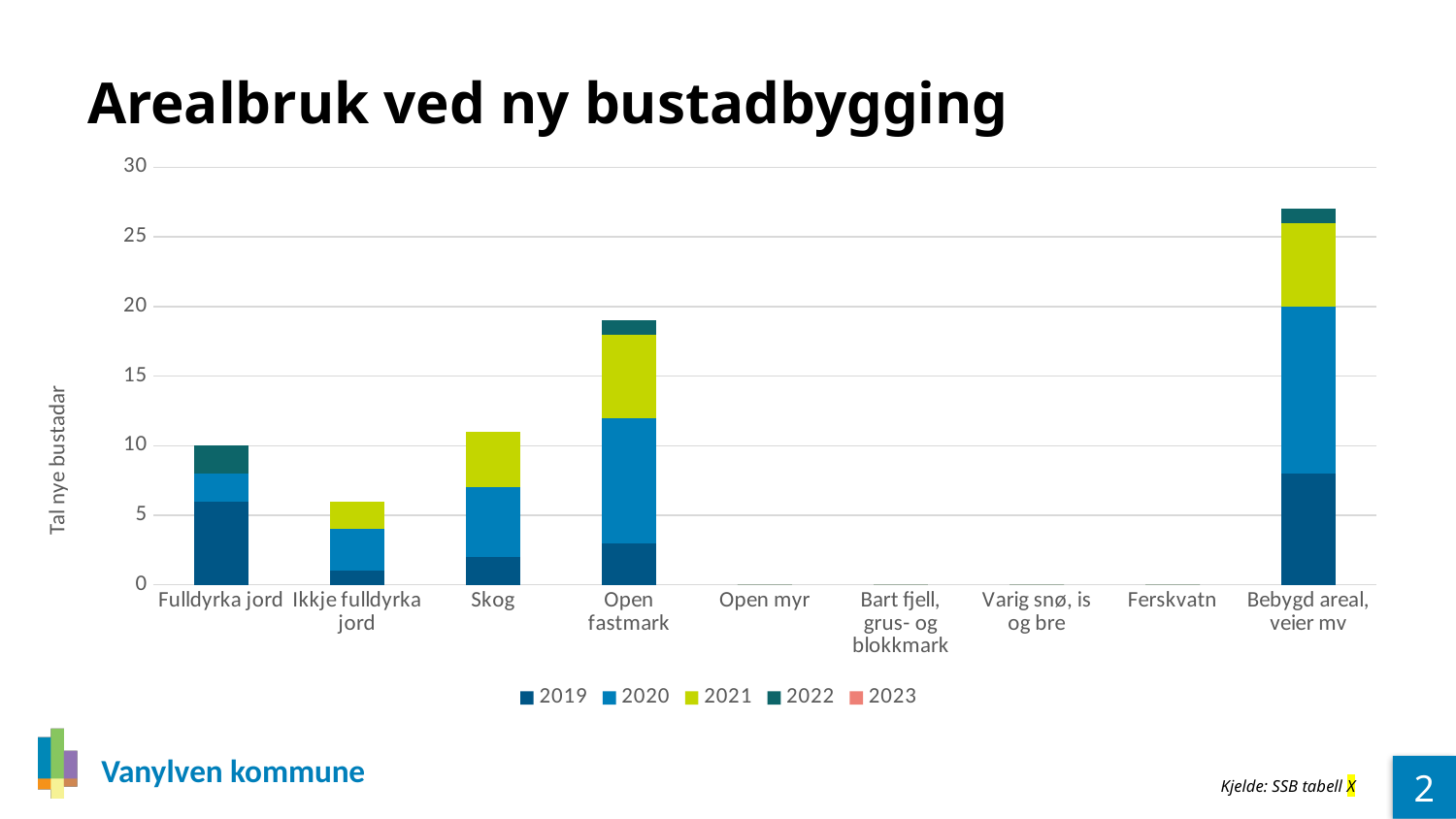
Which has the taller stacked bar, Open fastmark or Skog? Open fastmark What is the title of the chart? Arealbruk ved ny bustadbygging Is the total for Skog greater or less than 15? less Is the total for Bebygd areal, veier mv greater or less than 25? greater Is the total for Open fastmark greater or less than 15? greater Which has the taller stacked bar, Bebygd areal, veier mv or Open fastmark? Bebygd areal, veier mv How many series does the chart's legend list? 5 Which category has the tallest stacked bar? Bebygd areal, veier mv What is the label on the y axis of the chart? Tal nye bustadar What kind of chart is shown on the slide? stacked bar chart How many categories are shown on the x axis of the chart? 9